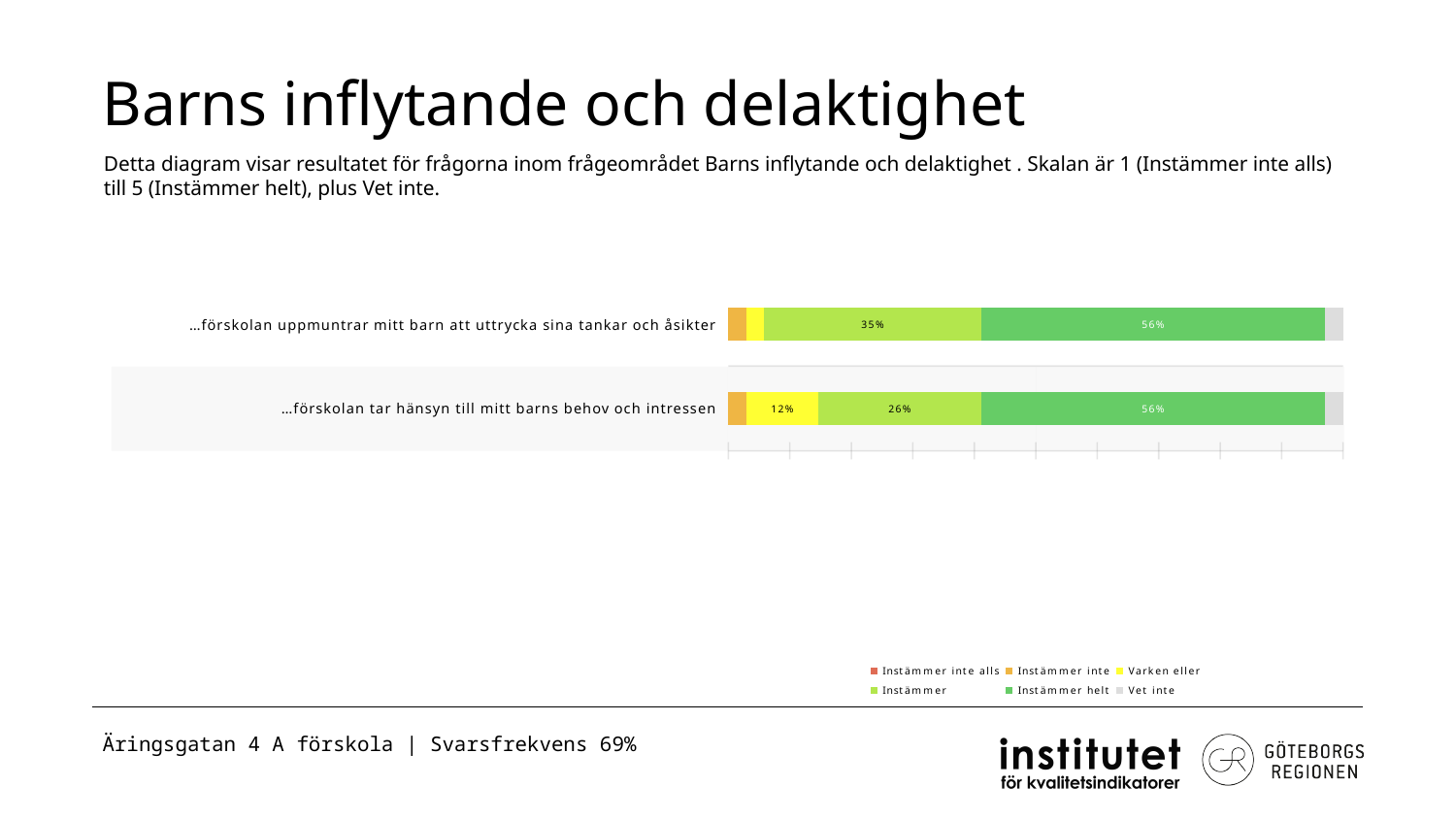
How many statements (bars) are shown in the chart? 2 What percentage of respondents answered "Instämmer helt" for "…förskolan tar hänsyn till mitt barns behov och intressen"? 56% What percentage of respondents answered "Instämmer" for "…förskolan tar hänsyn till mitt barns behov och intressen"? 26% How many response categories does the legend list? 6 What is the difference in the "Instämmer" share between the two statements? 9% What is the title of the slide? Barns inflytande och delaktighet What percentage of respondents answered "Instämmer helt" for "…förskolan uppmuntrar mitt barn att uttrycka sina tankar och åsikter"? 56% What type of chart is shown on the slide? Stacked bar chart Which legend entry is shown in dark green? Instämmer helt What percentage of respondents answered "Varken eller" for "…förskolan tar hänsyn till mitt barns behov och intressen"? 12% Which statement has the larger "Instämmer" share: "…förskolan uppmuntrar mitt barn att uttrycka sina tankar och åsikter" or "…förskolan tar hänsyn till mitt barns behov och intressen"? …förskolan uppmuntrar mitt barn att uttrycka sina tankar och åsikter What percentage of respondents answered "Instämmer" for "…förskolan uppmuntrar mitt barn att uttrycka sina tankar och åsikter"? 35%